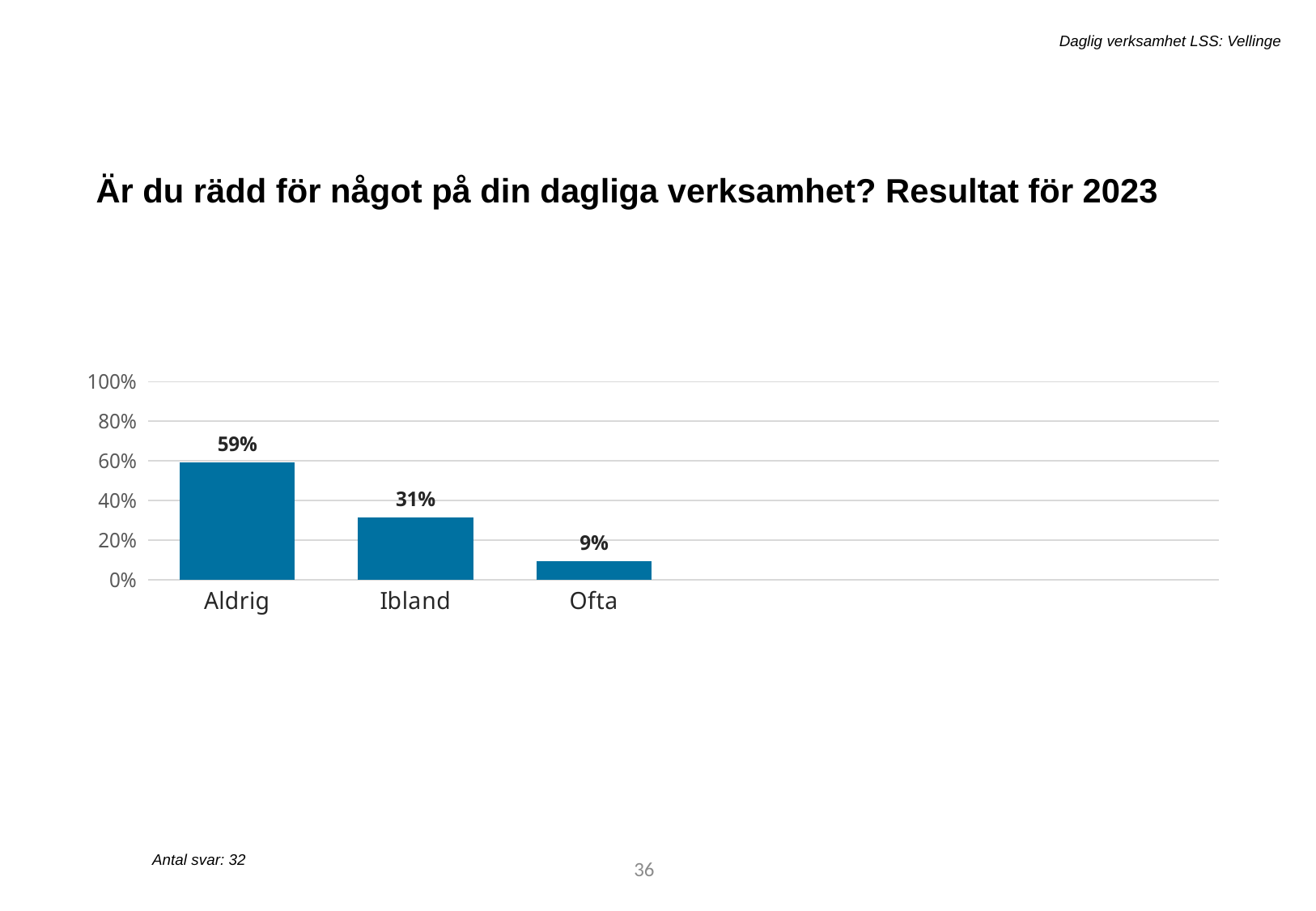
Which is larger, the value for Ibland or the value for Ofta? Ibland Do the values rise or fall from left to right along the x axis? fall Which category has the lowest value? Ofta What is the value for Ibland? 31% What is the value for Aldrig? 59% What is the difference between the values for Ibland and Ofta? 22% What is the difference between the values for Aldrig and Ibland? 28% Which category has the highest value? Aldrig What kind of chart is shown on the slide? bar chart Is the value for Aldrig greater or less than 40%? greater What is the value for Ofta? 9% How many categories are shown on the x axis? 3